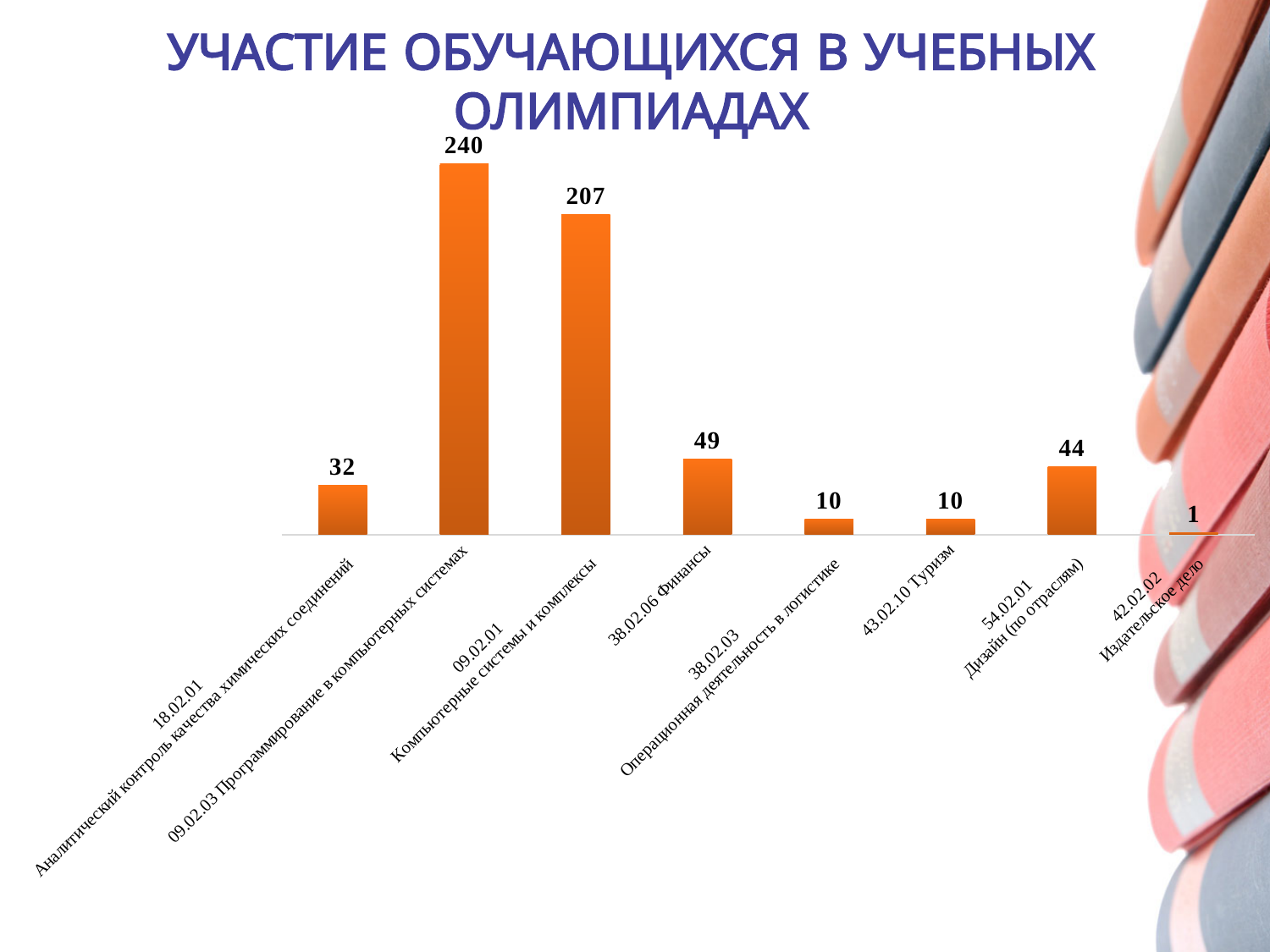
What is the value for 54.02.01 Дизайн (по отраслям)? 44 What is the value for 09.02.03 Программирование в компьютерных системах? 240 Which is larger, the value for 18.02.01 Аналитический контроль качества химических соединений or the value for 54.02.01 Дизайн (по отраслям)? 54.02.01 Дизайн (по отраслям) How many categories are shown in the chart? 8 Which category has the highest value? 09.02.03 Программирование в компьютерных системах Which category has the lowest value? 42.02.02 Издательское дело What is the title of the slide? УЧАСТИЕ ОБУЧАЮЩИХСЯ В УЧЕБНЫХ ОЛИМПИАДАХ What is the difference between the values for 38.02.06 Финансы and 54.02.01 Дизайн (по отраслям)? 5 What is the value for 38.02.06 Финансы? 49 What is the difference between the values for 09.02.03 Программирование в компьютерных системах and 09.02.01 Компьютерные системы и комплексы? 33 What is the value for 18.02.01 Аналитический контроль качества химических соединений? 32 What kind of chart is shown on the slide? Bar chart